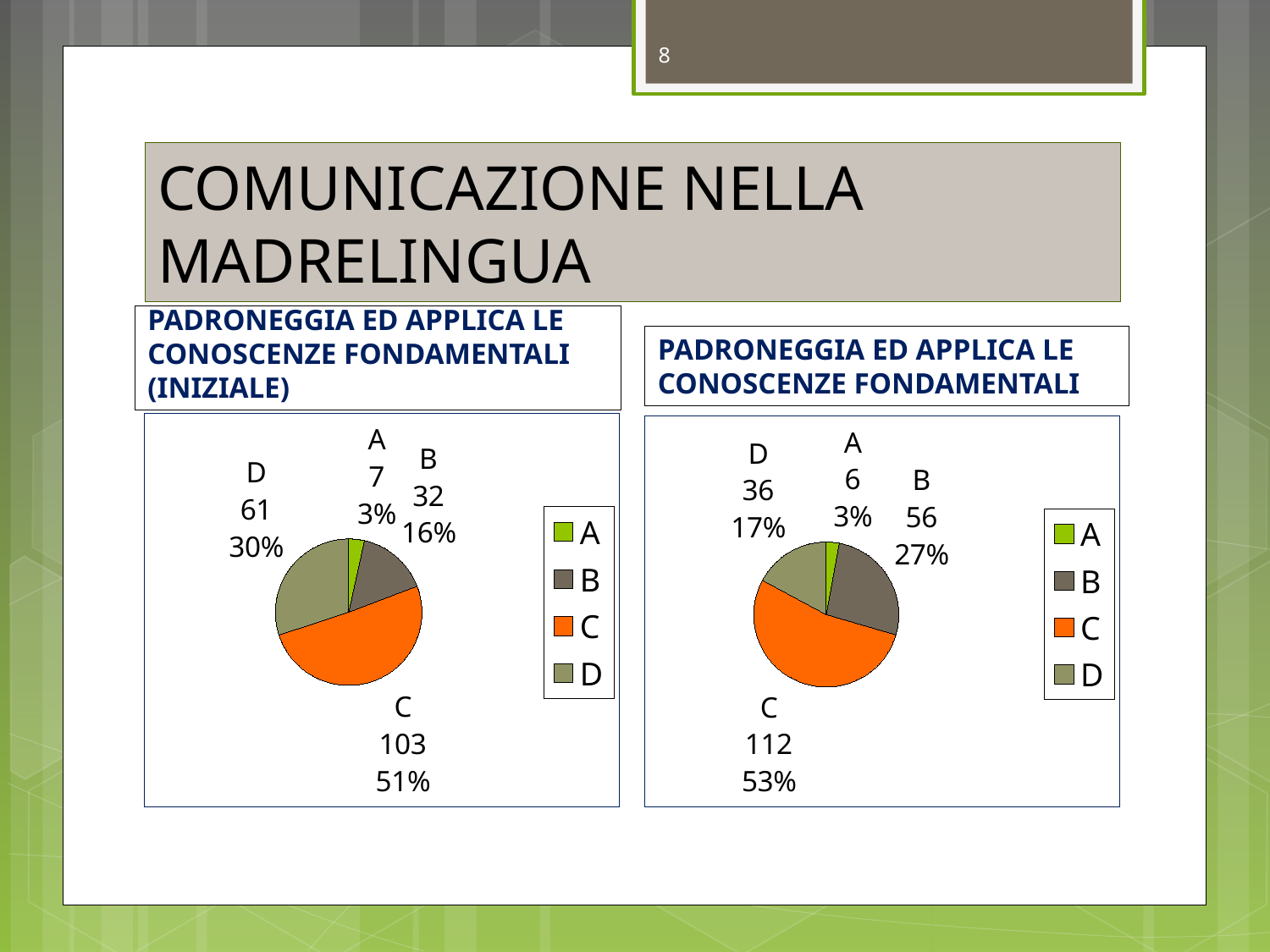
In the right pie chart (PADRONEGGIA ED APPLICA LE CONOSCENZE FONDAMENTALI), what is the value for category B? 56 In the left pie chart (INIZIALE), which category has the largest slice? C How many categories does the left pie chart (INIZIALE) show? 4 What colour represents category C in the legend of the left pie chart? Orange What type of chart is used on the right side of the slide? Pie chart In the left pie chart (INIZIALE), what is the value for category C? 103 In the left pie chart (INIZIALE), what percentage share does category D have? 30% In the right pie chart, what percentage share does category C have? 53% In the right pie chart, which category has the smallest slice? A In the right pie chart, which is larger, the value for B or the value for D? B In the right pie chart, what is the total of all four category values? 210 In the left pie chart (INIZIALE), what is the difference between the values for C and D? 42